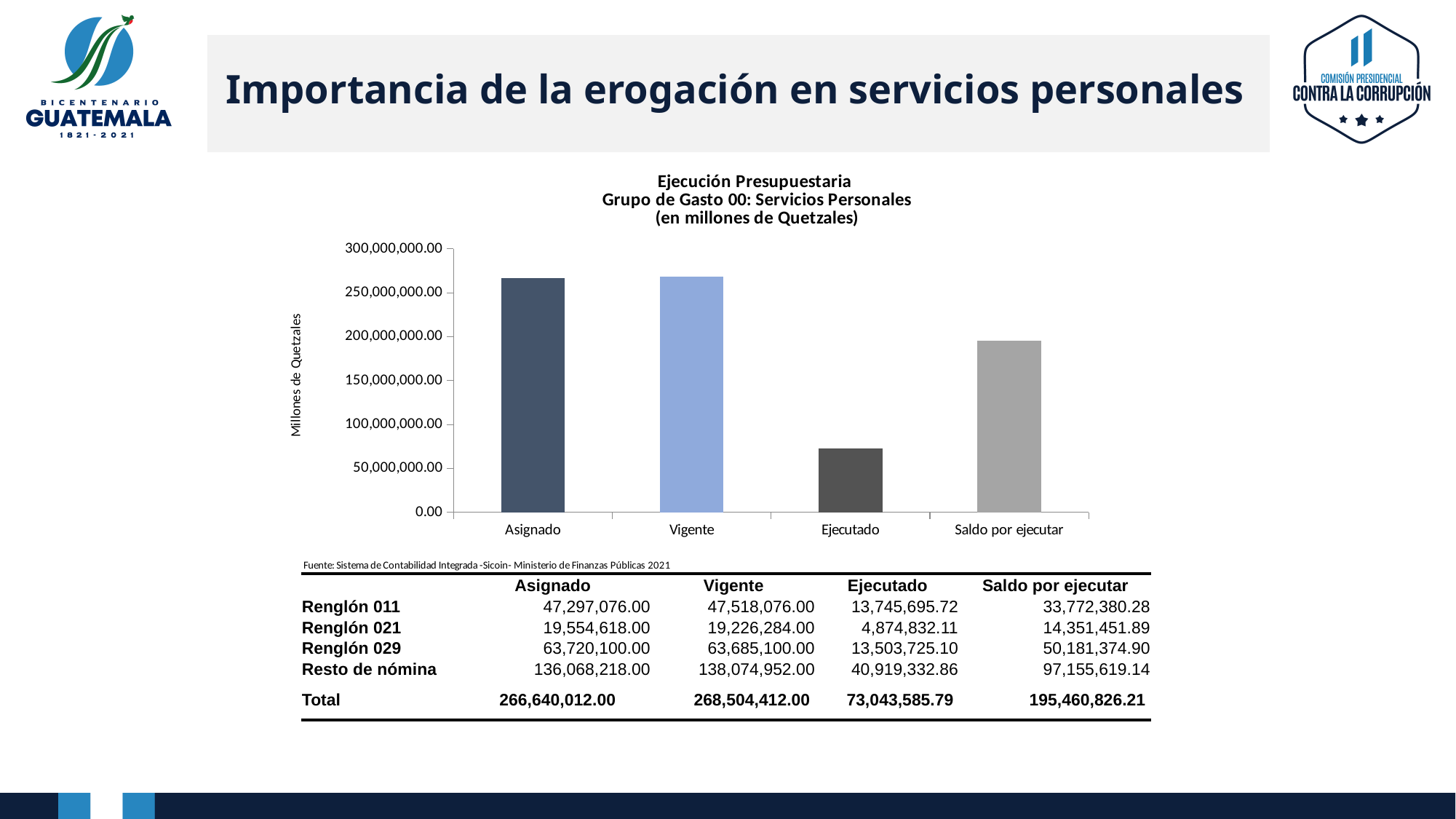
According to the Total row of the table, what is the Saldo por ejecutar value plotted in the chart? 195,460,826.21 How many categories are shown on the x axis of the chart? 4 What is the first line of the chart's title? Ejecución Presupuestaria Is the value for Asignado greater or less than 250,000,000.00? greater Using the Total row of the table, what is the difference between the Vigente and Ejecutado values? 195,460,826.21 Is the value for Saldo por ejecutar greater or less than 150,000,000.00? greater Is the value for Ejecutado greater or less than 100,000,000.00? less Which is larger, the bar for Saldo por ejecutar or the bar for Ejecutado? Saldo por ejecutar Which category has the lowest bar in the chart? Ejecutado What type of chart is shown on the slide? bar chart What is the label of the vertical axis of the chart? Millones de Quetzales According to the Total row of the table, what is the Ejecutado value plotted in the chart? 73,043,585.79